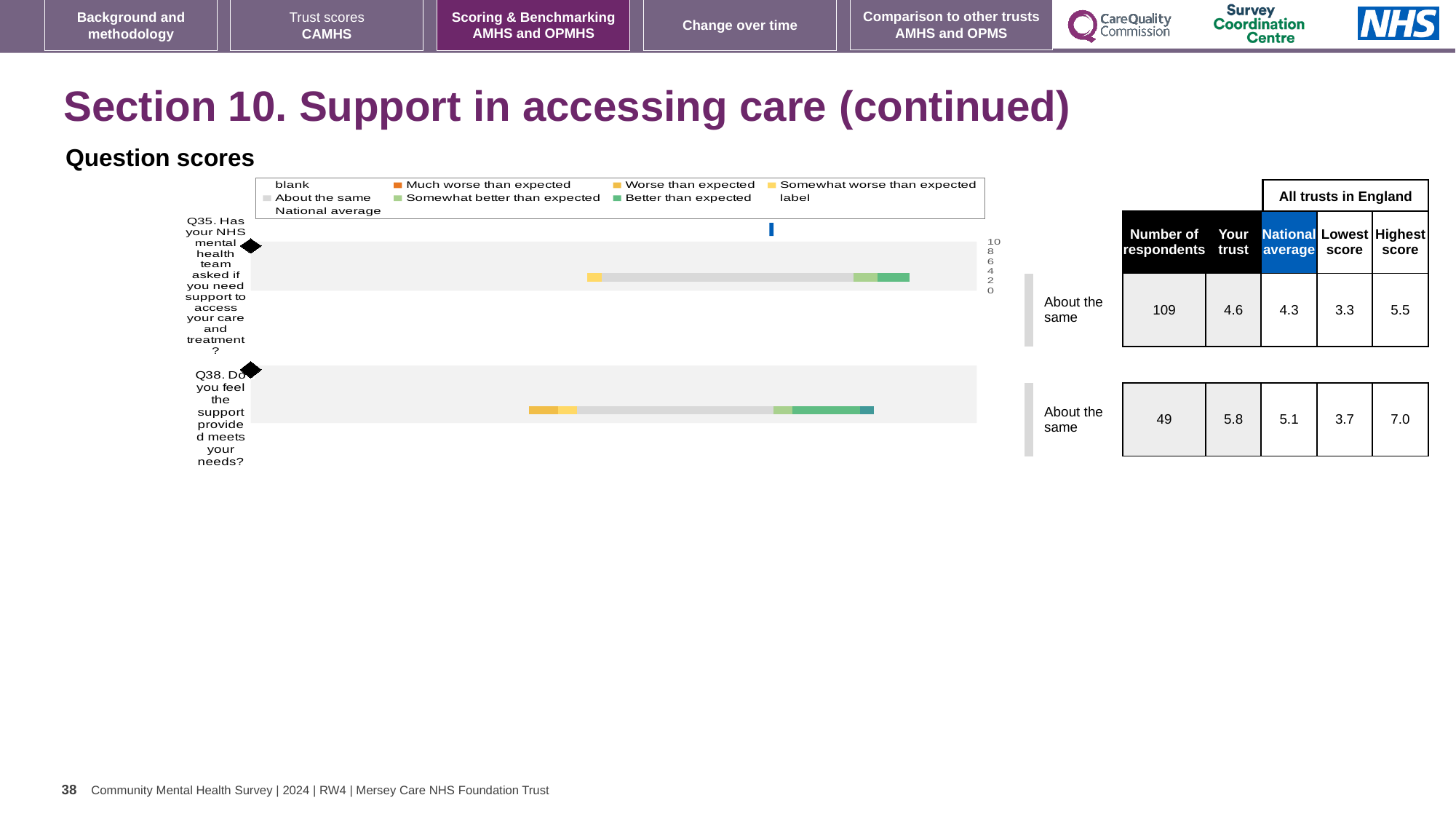
What benchmark category is shown next to the chart for both Q35 and Q38? About the same What is the difference between the 'Your trust' score and the national average for Q35? 0.3 Which question has the higher 'Your trust' score, Q35 or Q38? Q38 How many respondents answered Q35? 109 What is the 'Your trust' score for Q38 (Do you feel the support provided meets your needs?)? 5.8 What kind of chart is used to show the question scores on this slide? bar chart What is the difference between the highest and lowest scores across all trusts in England for Q38? 3.3 What is the highest score across all trusts in England for Q38? 7.0 How many questions (categories) are plotted in the chart? 2 What is the 'Your trust' score for Q35 (Has your NHS mental health team asked if you need support to access your care and treatment?)? 4.6 How many entries does the chart legend list? 9 What is the national average for Q38? 5.1